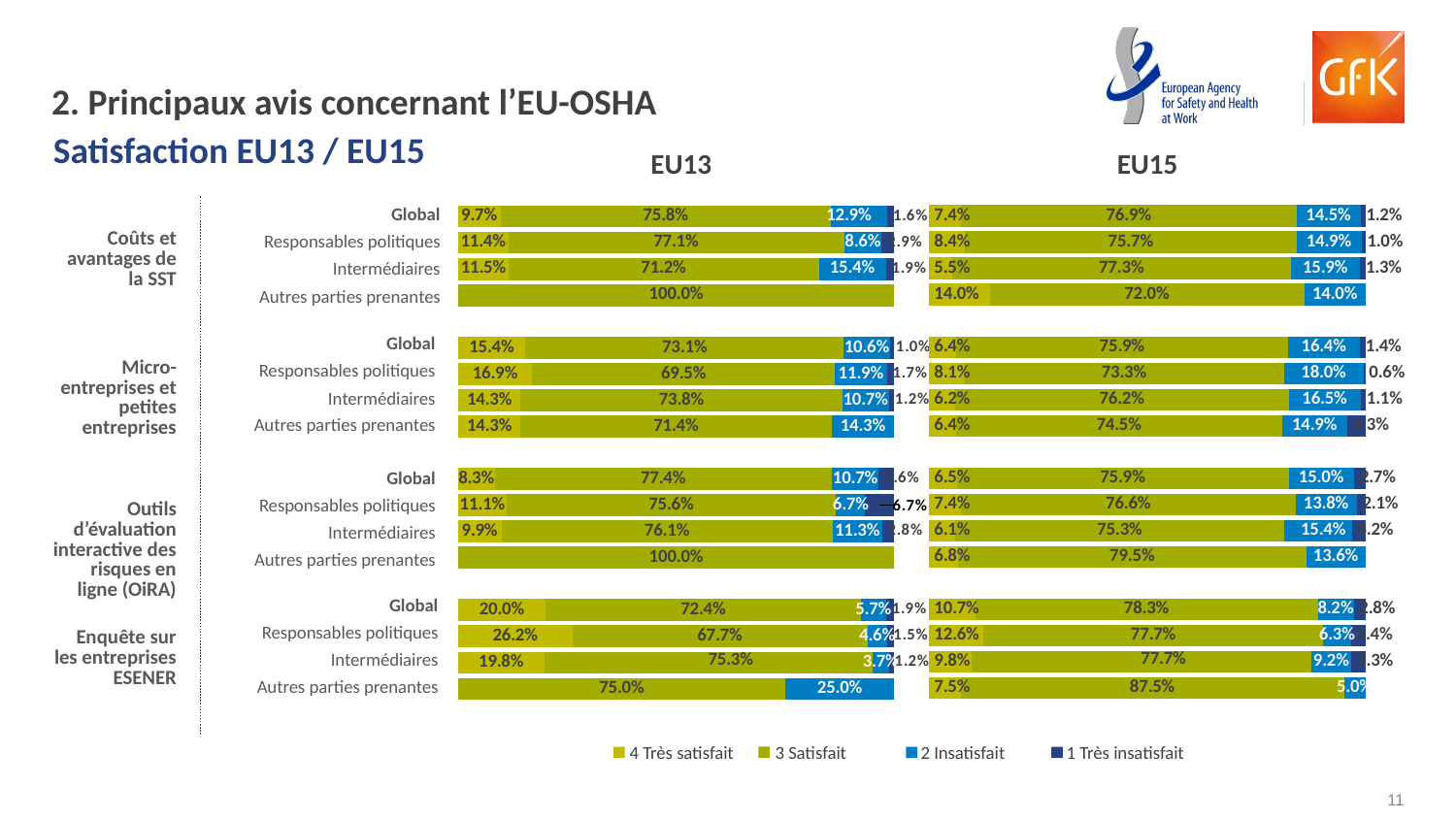
In the EU15 chart, what is the '3 Satisfait' value for Autres parties prenantes under 'Outils d'évaluation interactive des risques en ligne (OiRA)'? 79.5% In the EU13 chart, what is the '3 Satisfait' value for Global under 'Coûts et avantages de la SST'? 75.8% In the EU15 chart, what is the '4 Très satisfait' value for Responsables politiques under 'Micro-entreprises et petites entreprises'? 8.1% In the EU13 chart, what is the '3 Satisfait' value for Autres parties prenantes under 'Coûts et avantages de la SST'? 100.0% In the EU13 chart, what is the difference between the '3 Satisfait' values for Global and Responsables politiques under 'Enquête sur les entreprises ESENER'? 4.7% What kind of chart is used for EU13 and EU15? Stacked bar chart In the EU15 chart, what is the '2 Insatisfait' value for Autres parties prenantes under 'Coûts et avantages de la SST'? 14.0% Which is larger: the '4 Très satisfait' value for Global under 'Micro-entreprises et petites entreprises' in the EU13 chart or in the EU15 chart? EU13 How many series does the legend list for the charts? 4 In the EU13 chart, what is the '2 Insatisfait' value for Autres parties prenantes under 'Enquête sur les entreprises ESENER'? 25.0% In the EU13 chart, which respondent group under 'Enquête sur les entreprises ESENER' has the highest '4 Très satisfait' value? Responsables politiques Which legend entry is shown in the darkest blue colour? 1 Très insatisfait